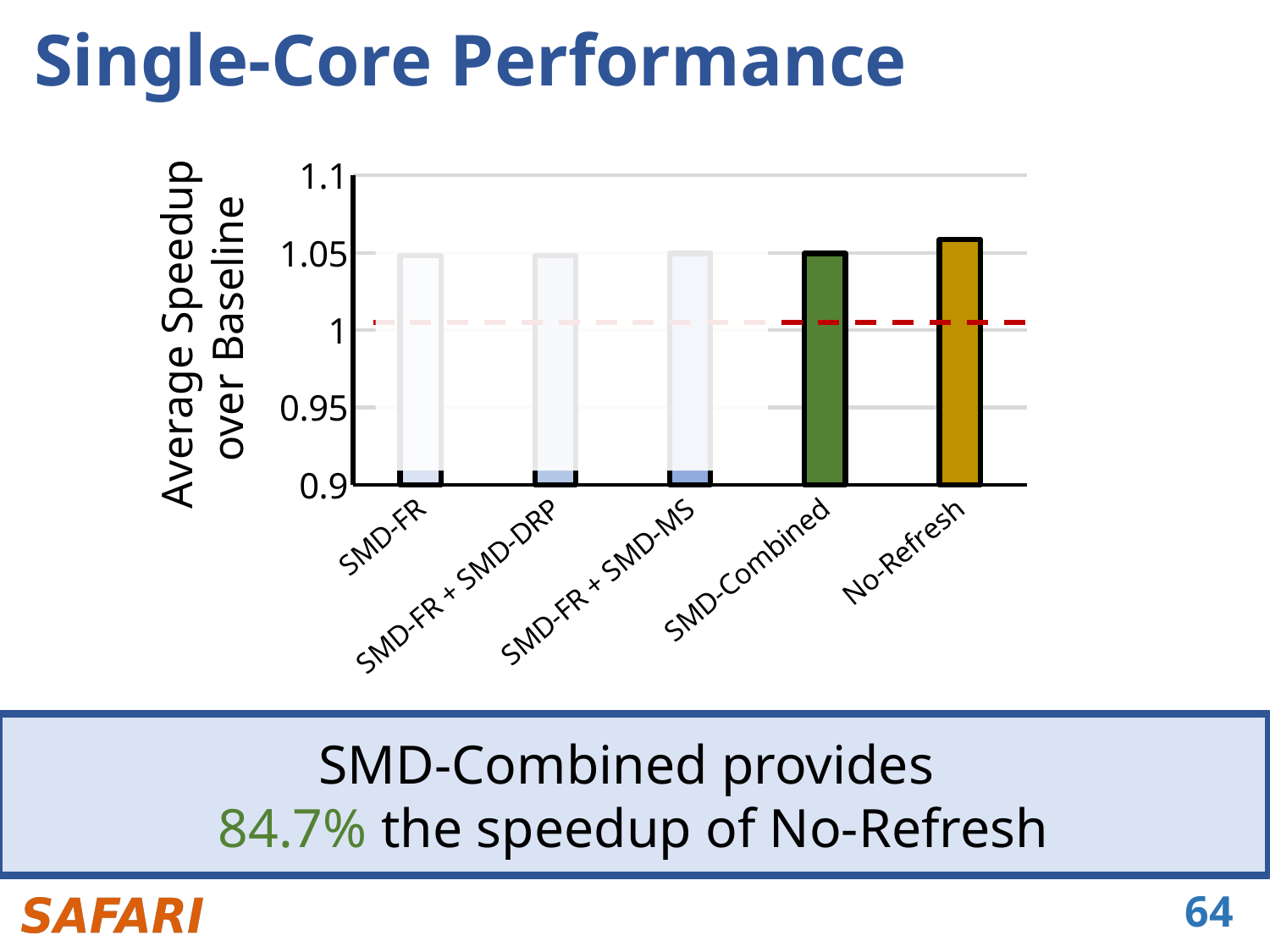
Is the average speedup for SMD-Combined greater or less than 1.1? less Is the average speedup for SMD-Combined greater or less than 1? greater Which category has the highest average speedup over baseline? No-Refresh How many categories are shown on the x axis of the chart? 5 Is the average speedup for No-Refresh greater or less than 1.1? less Which category's bar is coloured green? SMD-Combined What kind of chart is shown on the slide? bar chart What is the label of the y axis of the chart? Average Speedup over Baseline Which is larger, the average speedup for SMD-Combined or for No-Refresh? No-Refresh